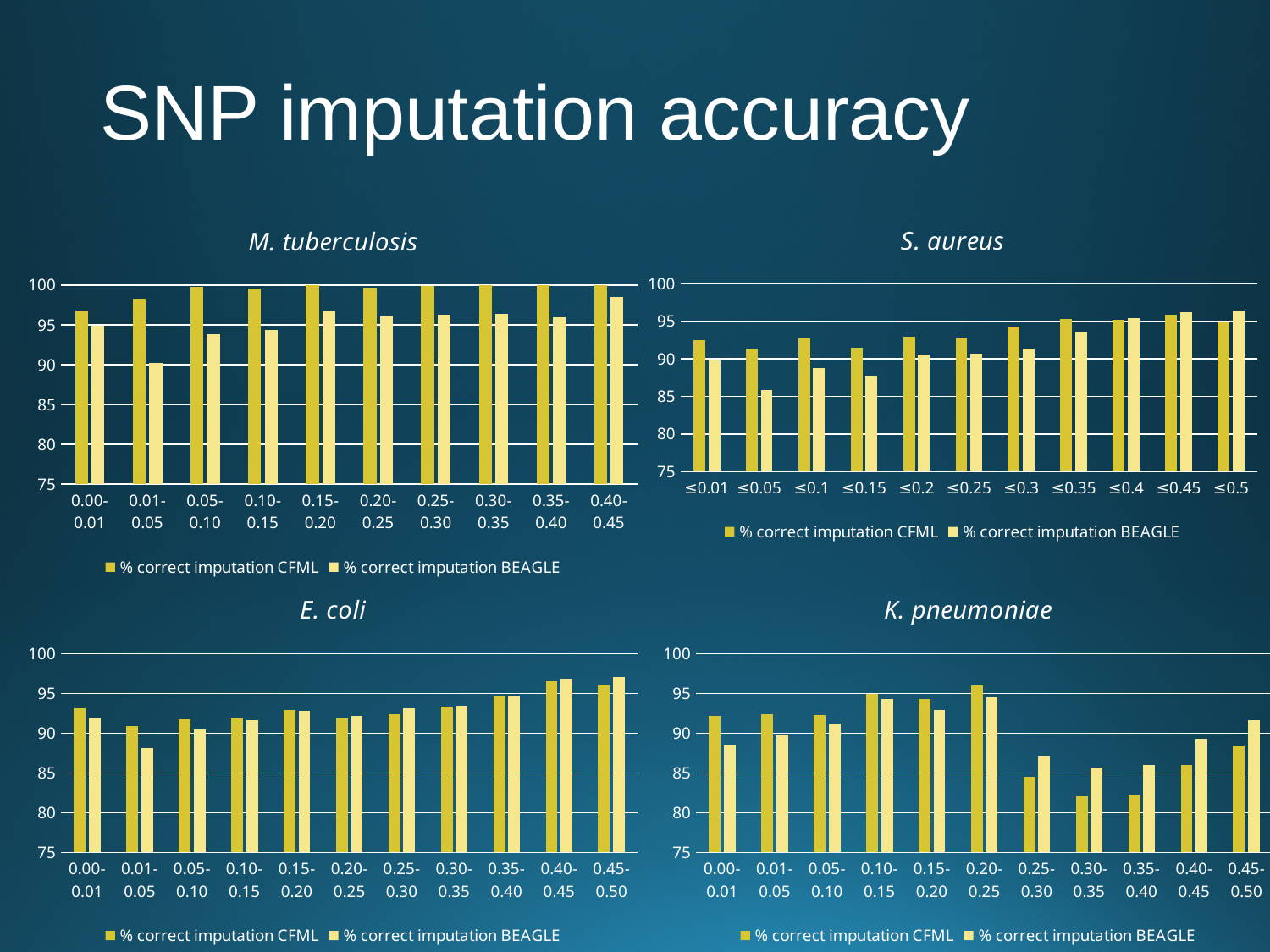
In the M. tuberculosis chart, is the value for % correct imputation BEAGLE at 0.05-0.10 greater or less than 95? less In the K. pneumoniae chart, at 0.25-0.30, which series has the larger value: % correct imputation CFML or % correct imputation BEAGLE? % correct imputation BEAGLE In the S. aureus chart, at ≤0.01, which series has the larger value: % correct imputation CFML or % correct imputation BEAGLE? % correct imputation CFML In the K. pneumoniae chart, is the value for % correct imputation CFML at 0.30-0.35 greater or less than 85? less How many categories are shown on the x axis of the E. coli chart? 11 In the E. coli chart, do the % correct imputation BEAGLE values generally rise or fall from 0.05-0.10 to 0.45-0.50? rise How many series does the legend of the S. aureus chart list? 2 How many categories are shown on the x axis of the M. tuberculosis chart? 10 In the M. tuberculosis chart, which category has the lowest value for % correct imputation BEAGLE? 0.01-0.05 In the E. coli chart, is the value for % correct imputation BEAGLE at 0.01-0.05 greater or less than 90? less In the S. aureus chart, which category has the lowest value for % correct imputation BEAGLE? ≤0.05 What type of chart is the M. tuberculosis chart? bar chart